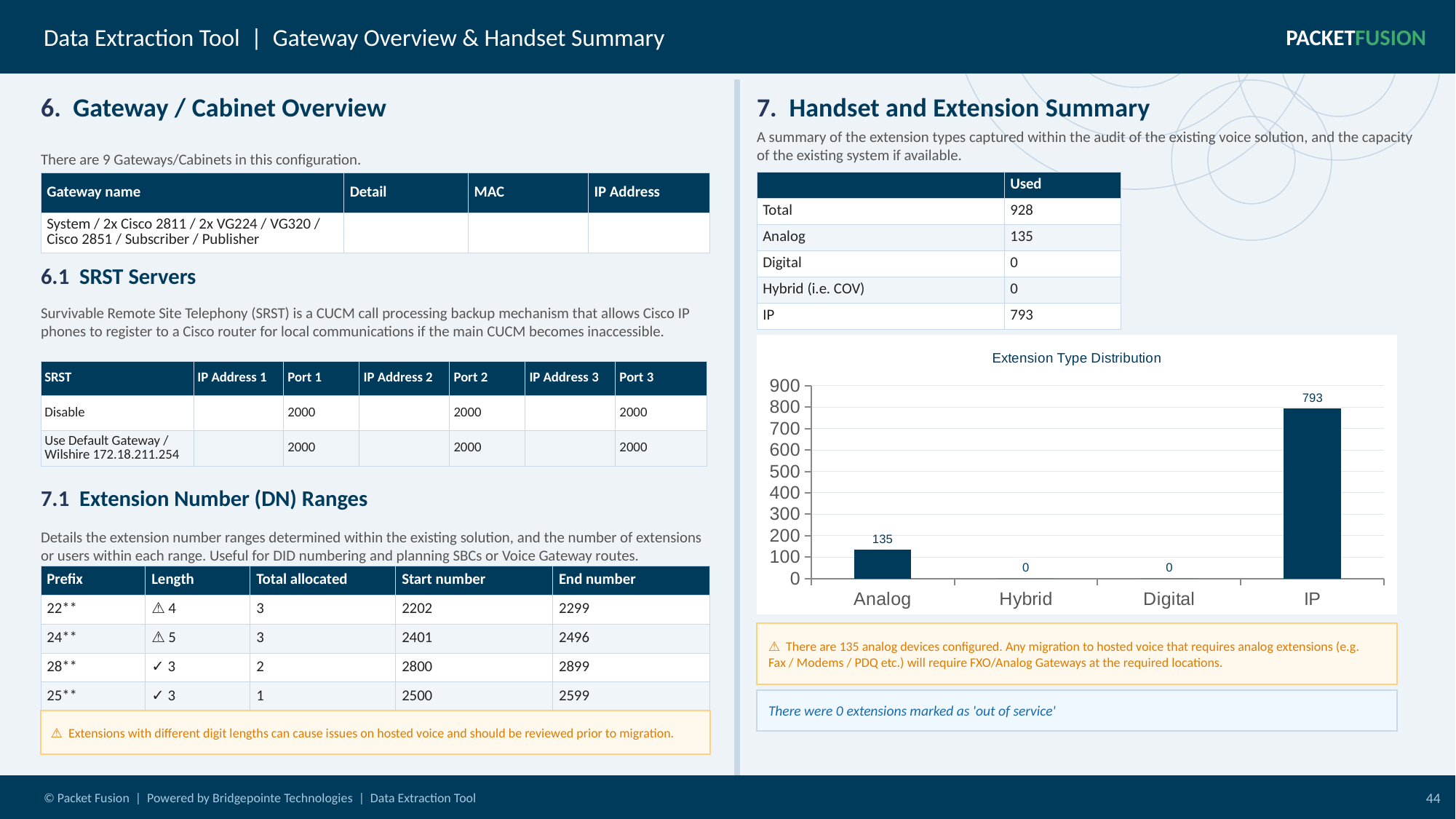
In the Extension Type Distribution chart, which is larger, Analog or IP? IP What is the title of the chart on the slide? Extension Type Distribution In the Extension Type Distribution chart, what is the total of all four category values? 928 In the Extension Type Distribution chart, what is the value for Hybrid? 0 In the Extension Type Distribution chart, how many categories have a value of 0? 2 How many categories are shown on the x axis of the Extension Type Distribution chart? 4 In the Extension Type Distribution chart, which category has the highest value? IP In the Extension Type Distribution chart, what is the difference between the IP and Analog values? 658 In the Extension Type Distribution chart, what is the value for Analog? 135 In the Extension Type Distribution chart, is the value for IP greater or less than 700? greater What type of chart is shown under the Handset and Extension Summary? bar chart In the Extension Type Distribution chart, what is the value for IP? 793